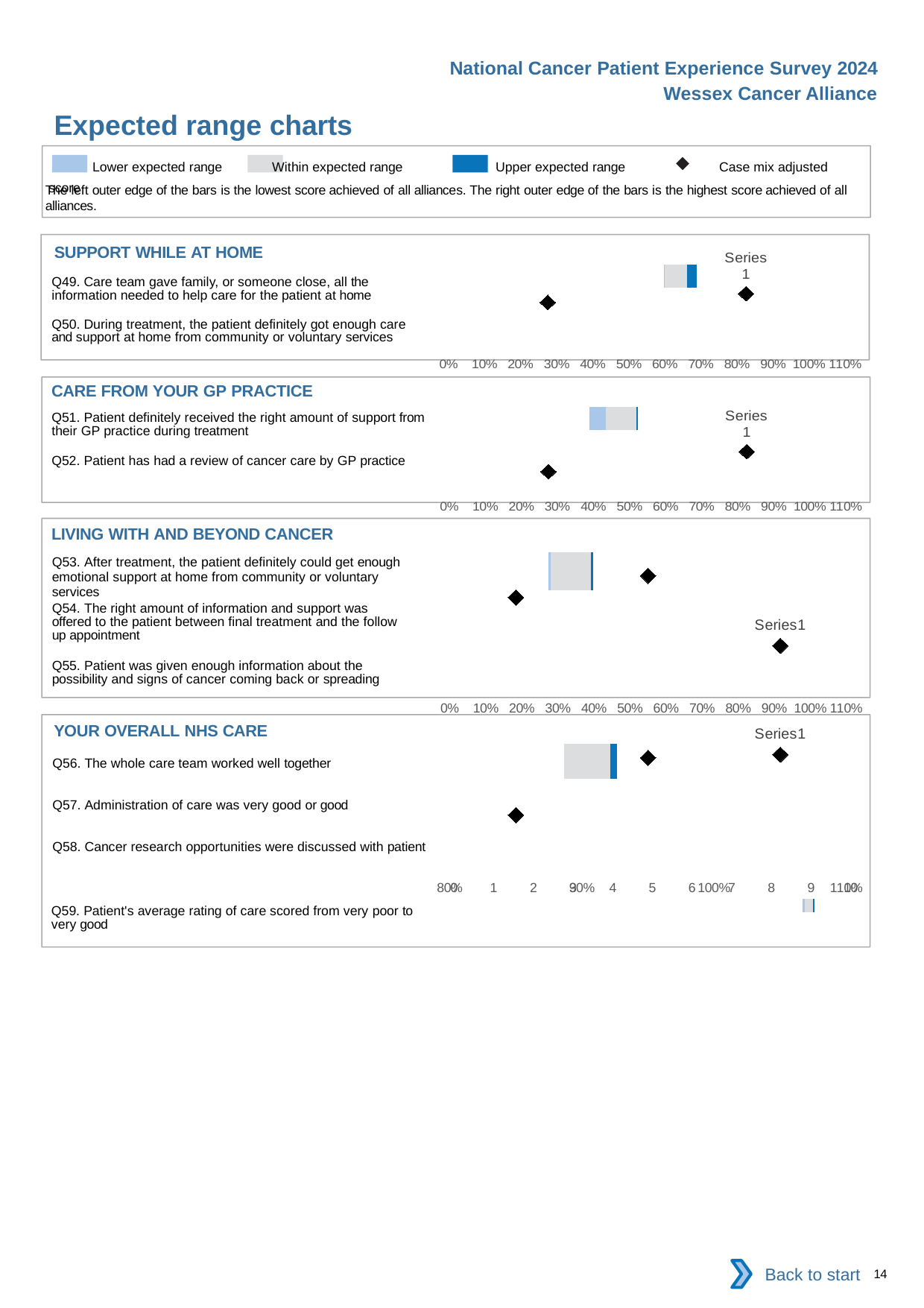
In the SUPPORT WHILE AT HOME chart, is the right edge of the expected range bar greater or less than 50%? greater How many entries does the legend at the top of the slide list? 4 In the CARE FROM YOUR GP PRACTICE chart, is the left edge of the expected range bar greater or less than 30%? greater According to the legend, which colour represents the Upper expected range? dark blue How many questions are listed in the LIVING WITH AND BEYOND CANCER chart? 3 How many questions are listed in the CARE FROM YOUR GP PRACTICE chart? 2 How many questions are listed in the YOUR OVERALL NHS CARE chart? 4 What kind of chart is used in the expected range charts on this slide? bar chart What is the title of the slide? Expected range charts